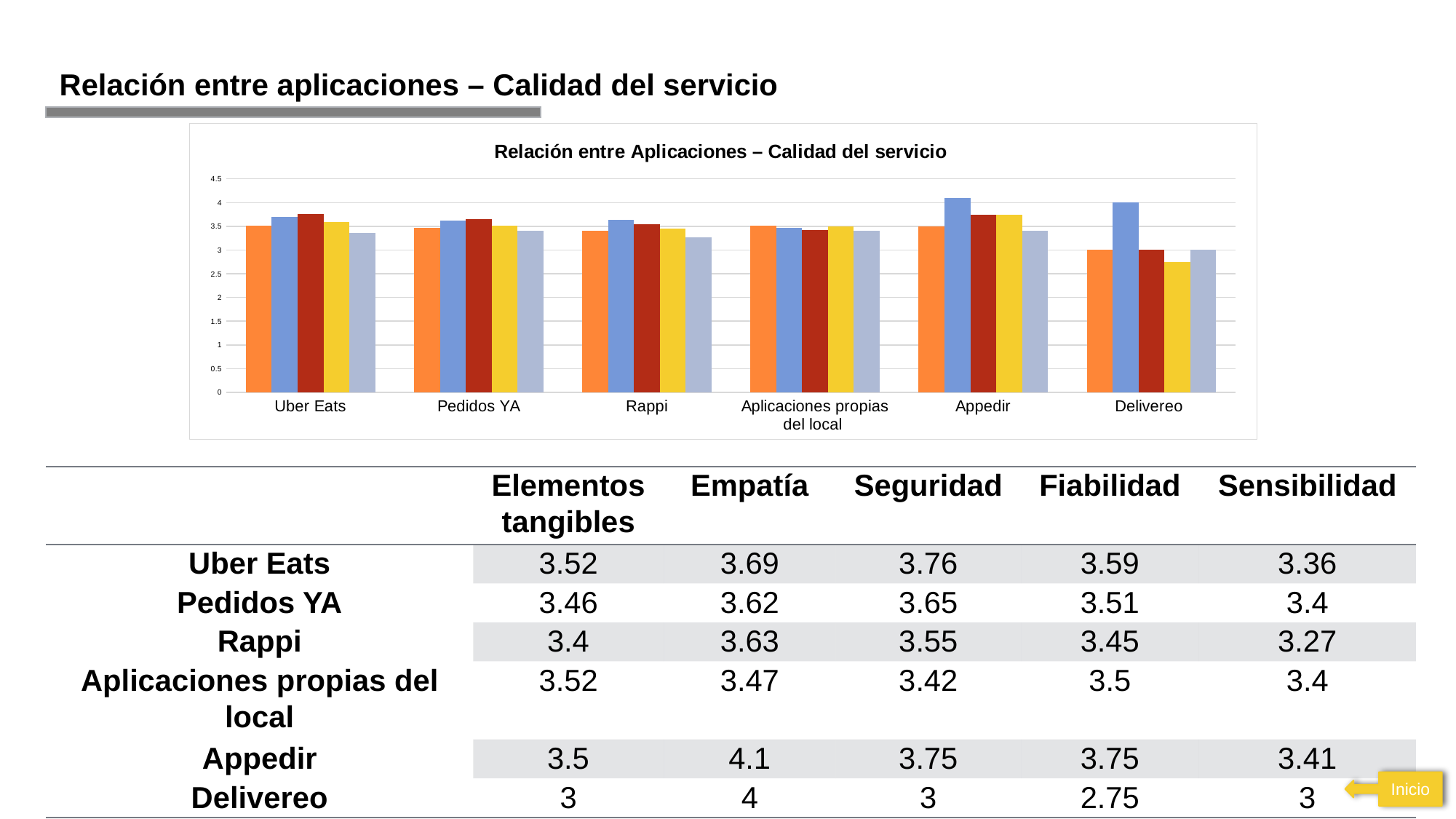
Which application has the lowest Fiabilidad value? Delivereo Is the Empatía value for Delivereo greater or less than 3.5? greater What is the Empatía value for Appedir? 4.1 What is the difference between the Empatía values of Appedir and Delivereo? 0.1 What is the Fiabilidad value for Delivereo? 2.75 Which application has the highest Empatía value? Appedir What is the title of the chart? Relación entre Aplicaciones – Calidad del servicio How many bars are plotted for each application category in the chart? 5 What kind of chart is shown on the slide? bar chart Which has a higher Seguridad value, Uber Eats or Rappi? Uber Eats What is the Seguridad value for Uber Eats? 3.76 How many application categories are shown on the x axis of the chart? 6